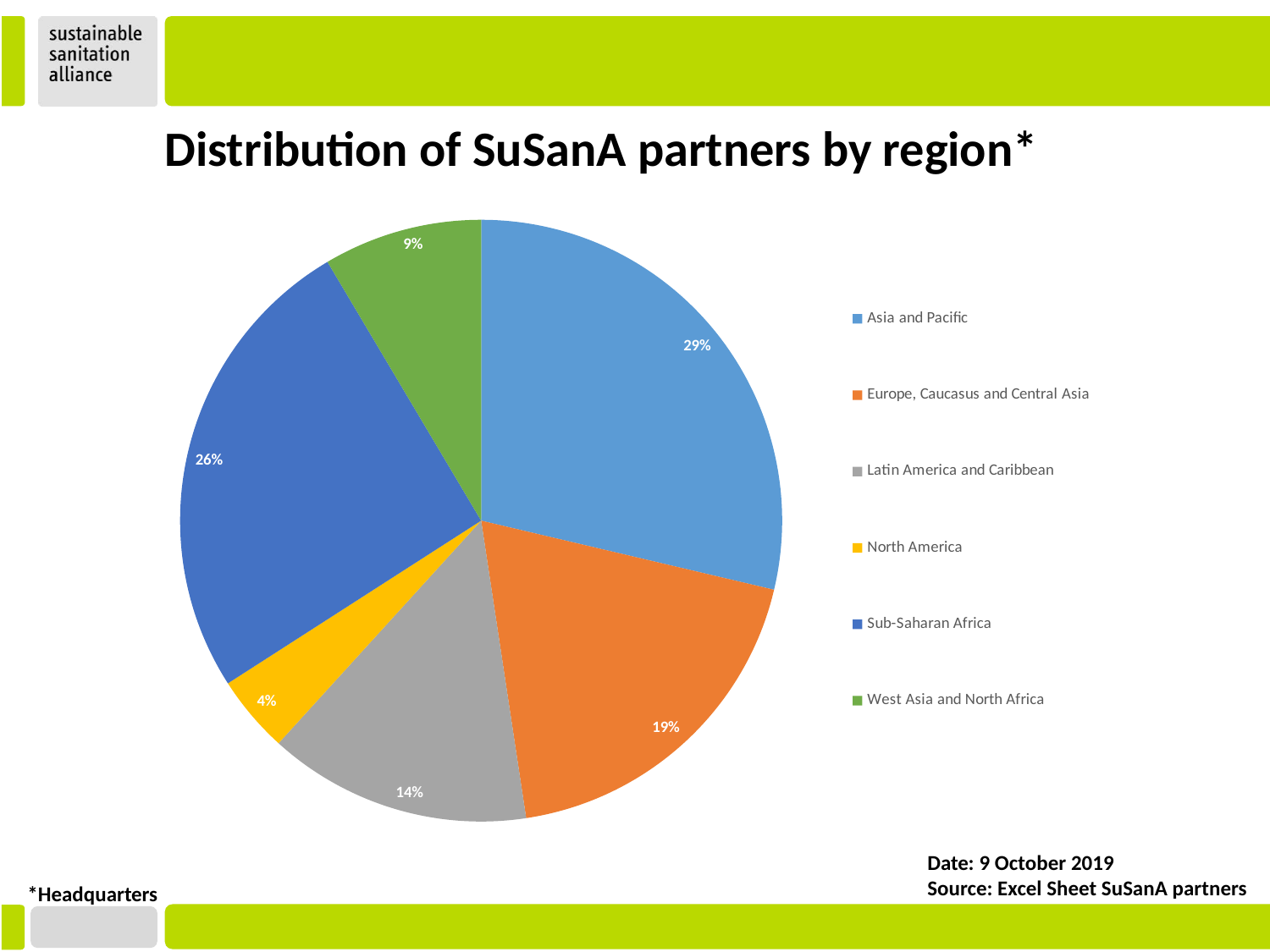
Which colour represents North America in the pie chart? Yellow What share of SuSanA partners is in North America? 4% What is the difference in percentage points between the Asia and Pacific share and the Sub-Saharan Africa share? 3 What kind of chart is shown on the slide? Pie chart Which region has the largest share of SuSanA partners? Asia and Pacific What share of SuSanA partners is in Sub-Saharan Africa? 26% How many regions are shown in the pie chart? 6 Which region has the smallest share of SuSanA partners? North America Which has a larger share: Latin America and Caribbean or West Asia and North Africa? Latin America and Caribbean What share of SuSanA partners is in Asia and Pacific? 29% What is the title of the chart? Distribution of SuSanA partners by region* What share of SuSanA partners is in Europe, Caucasus and Central Asia? 19%